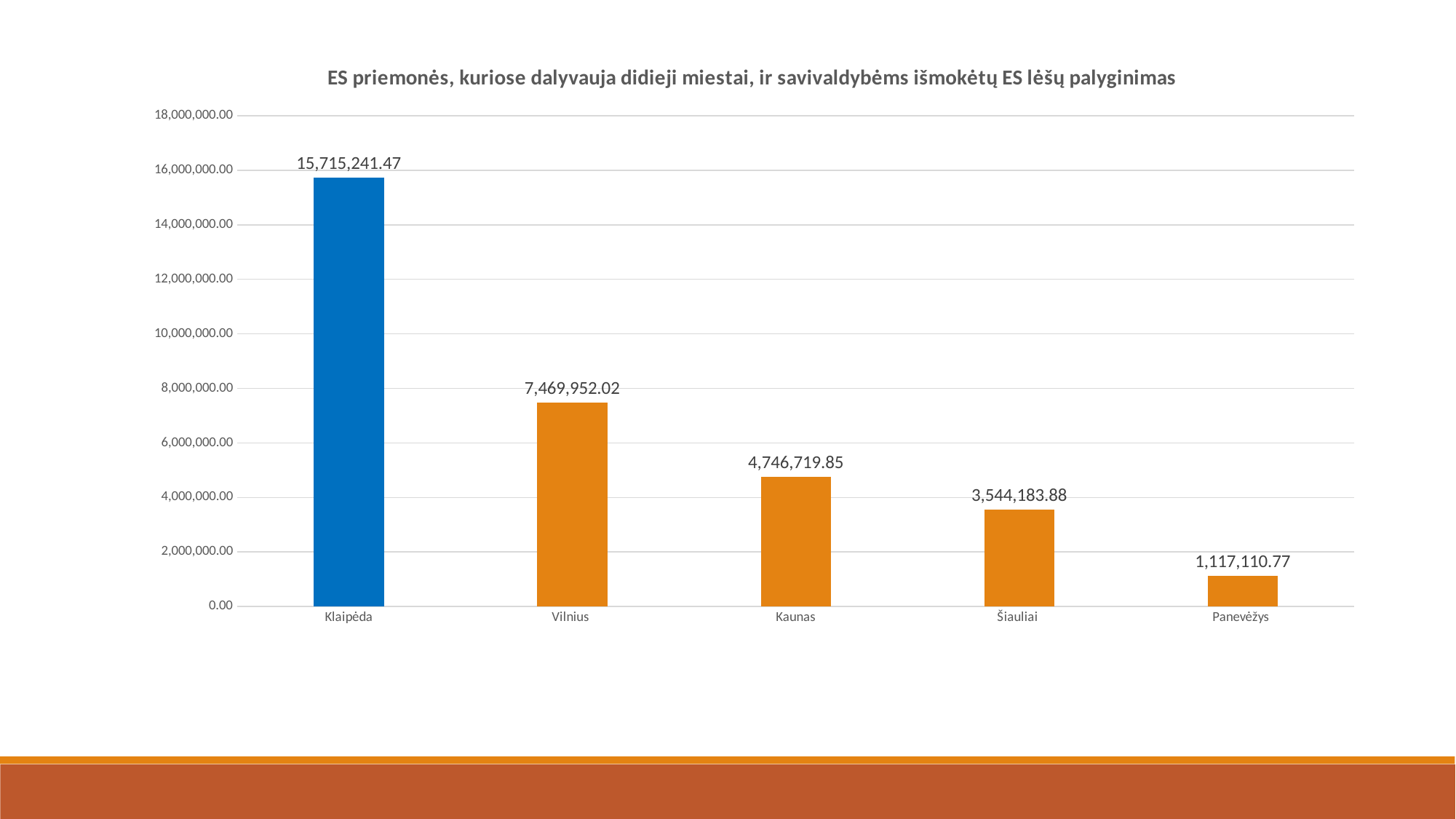
What is the value for Klaipėda? 15,715,241.47 Which city has the highest value? Klaipėda What kind of chart is shown on the slide? bar chart Is the value for Šiauliai greater or less than 4,000,000.00? less What is the difference between the values for Klaipėda and Vilnius? 8,245,289.45 What is the value for Panevėžys? 1,117,110.77 How many cities are shown on the chart? 5 Which is larger, the value for Vilnius or the value for Kaunas? Vilnius What is the value for Kaunas? 4,746,719.85 What is the difference between the values for Kaunas and Šiauliai? 1,202,535.97 Which city has the lowest value? Panevėžys What is the value for Vilnius? 7,469,952.02